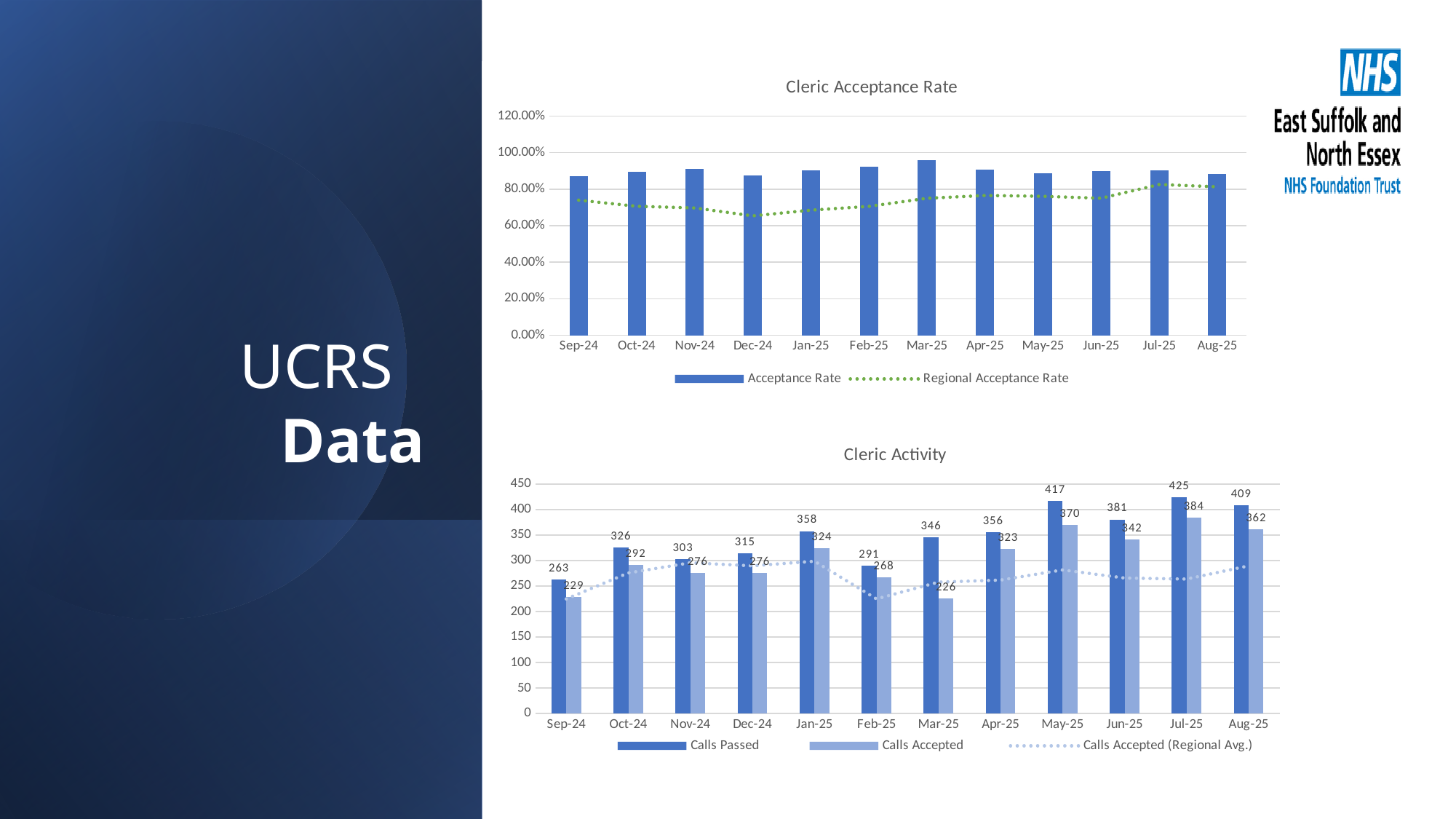
In the Cleric Activity chart, what is the value of Calls Passed for Jul-25? 425 In the Cleric Activity chart, which month has the highest Calls Passed? Jul-25 In the Cleric Acceptance Rate chart, is the Regional Acceptance Rate for Dec-24 greater or less than 80.00%? less In the Cleric Activity chart, how many series does the legend list? 3 In the Cleric Activity chart, what is the value of Calls Accepted for Mar-25? 226 In the Cleric Acceptance Rate chart, how many months are shown on the x axis? 12 In the Cleric Activity chart, which is larger: Calls Accepted in Jan-25 or Calls Accepted in Apr-25? Jan-25 What kind of chart is the Cleric Activity chart? Bar chart with a dotted line series In the Cleric Activity chart, what is the difference between Calls Passed and Calls Accepted in Mar-25? 120 In the Cleric Acceptance Rate chart, is the Acceptance Rate for Feb-25 greater or less than 80.00%? greater In the Cleric Acceptance Rate chart, which month has the highest Acceptance Rate bar? Mar-25 In the Cleric Activity chart, which month has the lowest Calls Passed? Sep-24